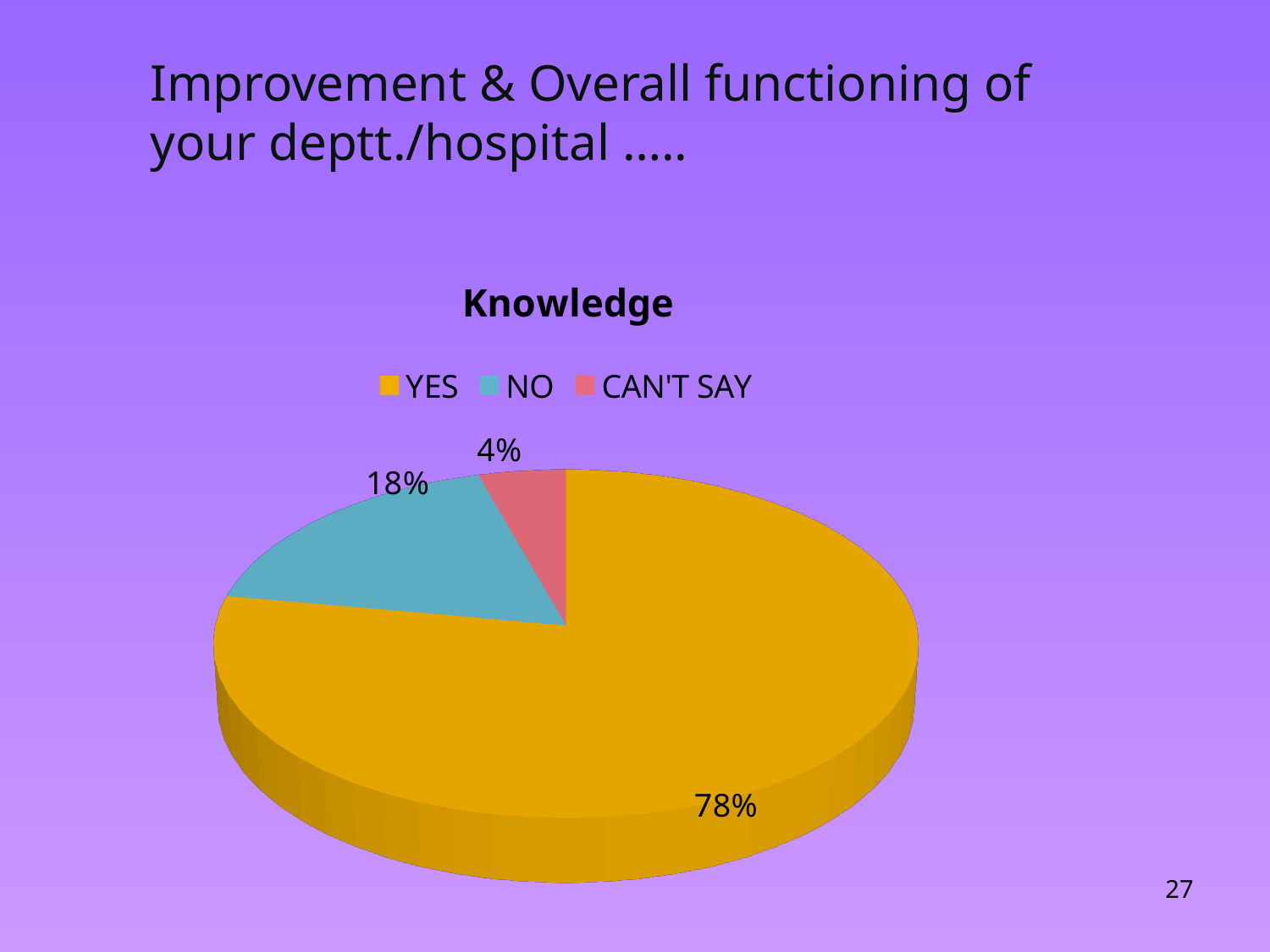
Which category has the smallest slice of the pie? CAN'T SAY What percentage of the pie is labelled NO? 18% What percentage of the pie is labelled CAN'T SAY? 4% What is the difference in percentage points between the NO and CAN'T SAY slices? 14 What is the difference in percentage points between the YES and NO slices? 60 What percentage of the pie is labelled YES? 78% What kind of chart is shown on the slide? Pie chart Which slice is larger, NO or CAN'T SAY? NO How many slices does the pie chart have? 3 How many entries does the legend list? 3 Which category has the largest slice of the pie? YES What is the title of the chart? Knowledge